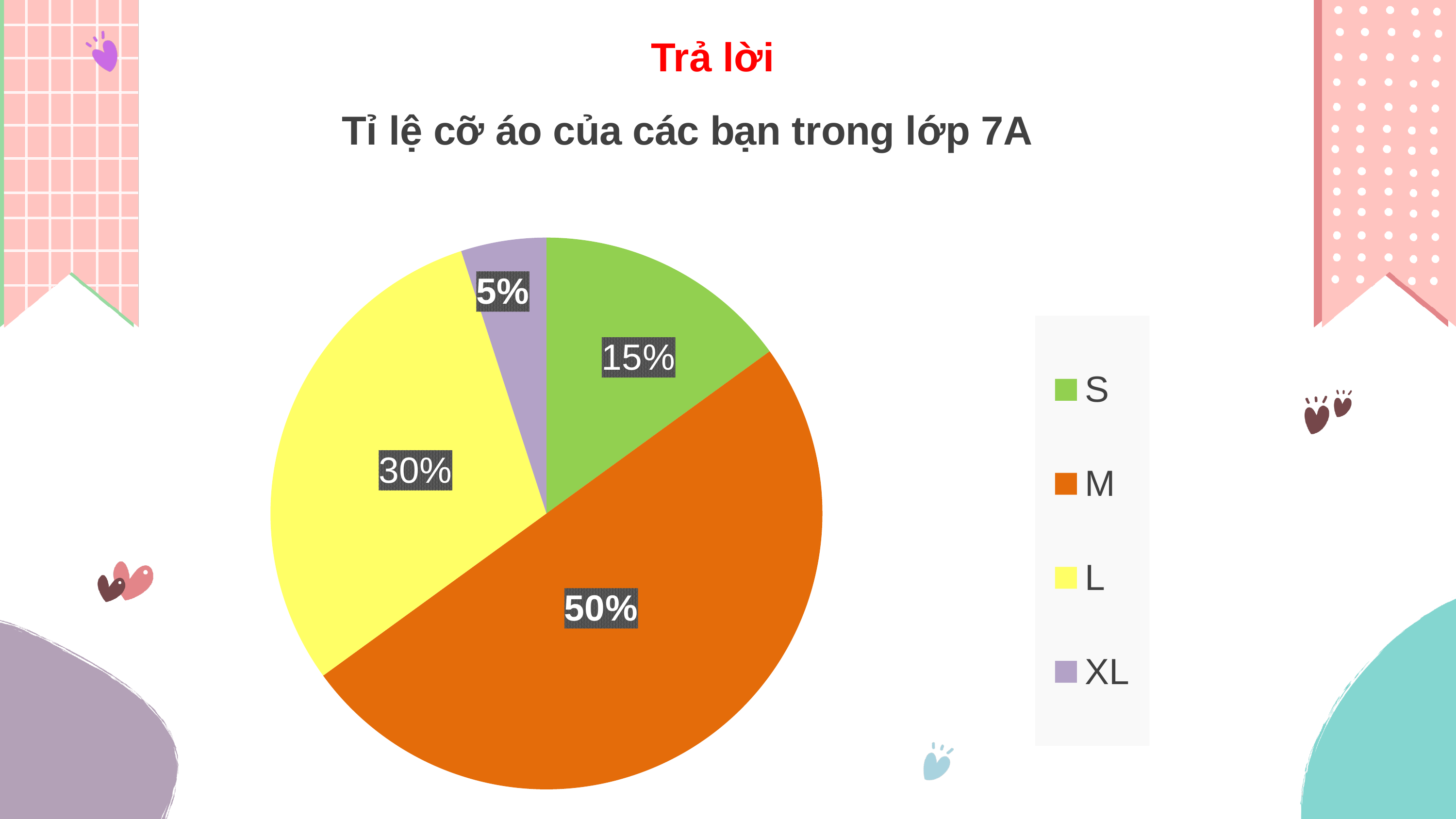
Which size has the largest share of the pie? M What percentage of the pie does size M represent? 50% Which has a larger share, size S or size L? L Which size has the smallest share of the pie? XL What is the difference in percentage points between size M and size L? 20% What is the title of the chart? Tỉ lệ cỡ áo của các bạn trong lớp 7A What type of chart is shown on the slide? pie chart What colour is the slice for size L? yellow What percentage of the pie does size S represent? 15% What percentage of the pie does size L represent? 30% How many categories does the legend list? 4 What percentage of the pie does size XL represent? 5%